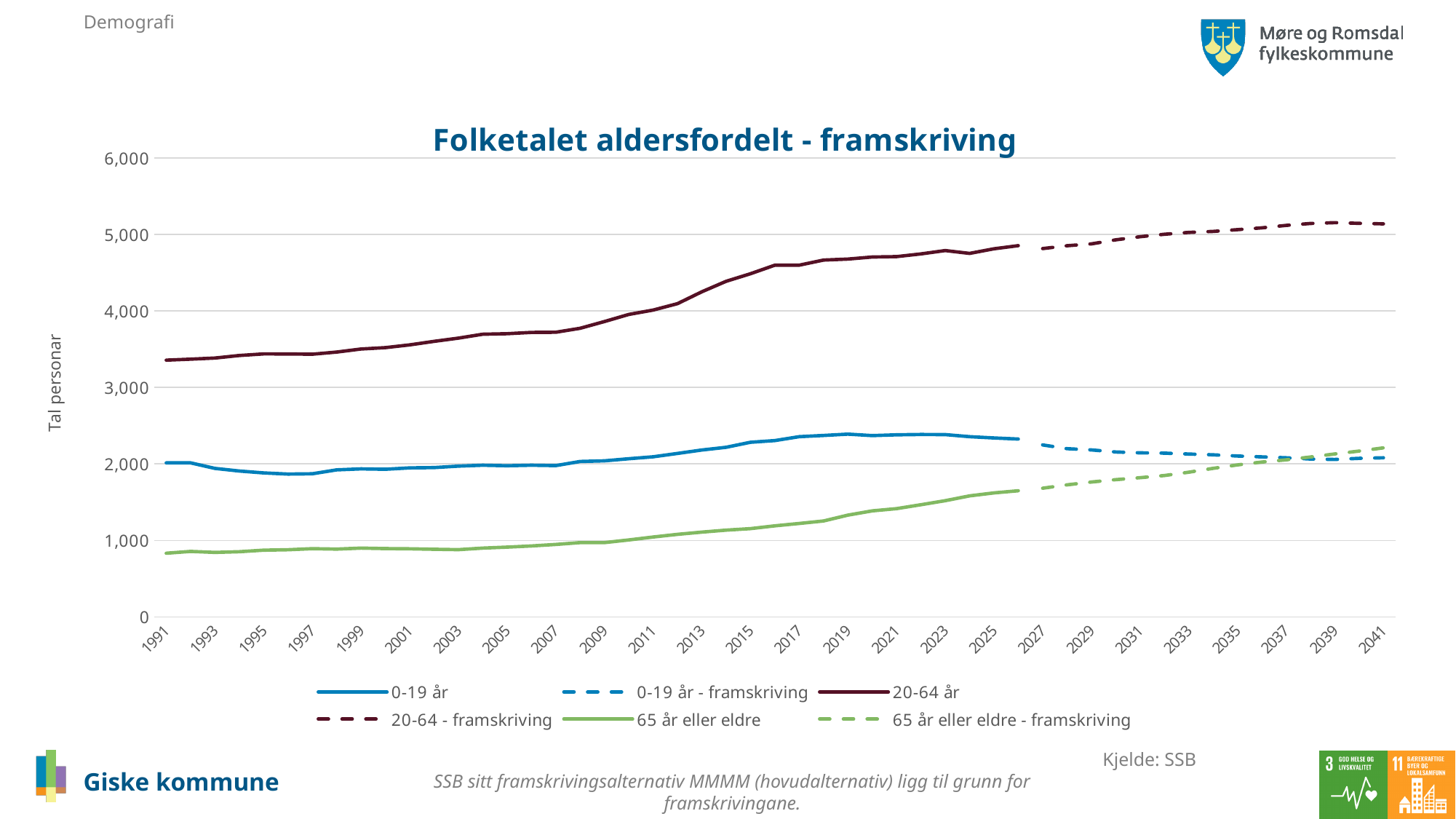
In 2041, which is higher: 0-19 år - framskriving or 65 år eller eldre - framskriving? 65 år eller eldre - framskriving What is the label on the vertical axis? Tal personar Does the 65 år eller eldre series rise or fall from 1991 to 2025? rise How many series does the legend list? 6 Is the value for 20-64 - framskriving in 2041 greater or less than 5,000? greater Is the value for 65 år eller eldre in 1991 greater or less than 1,000? less Is the value for 20-64 år in 2013 greater or less than 4,000? greater Which series has the highest values across the whole period? 20-64 år What kind of chart is shown on the slide? line chart What is the title of the chart? Folketalet aldersfordelt - framskriving